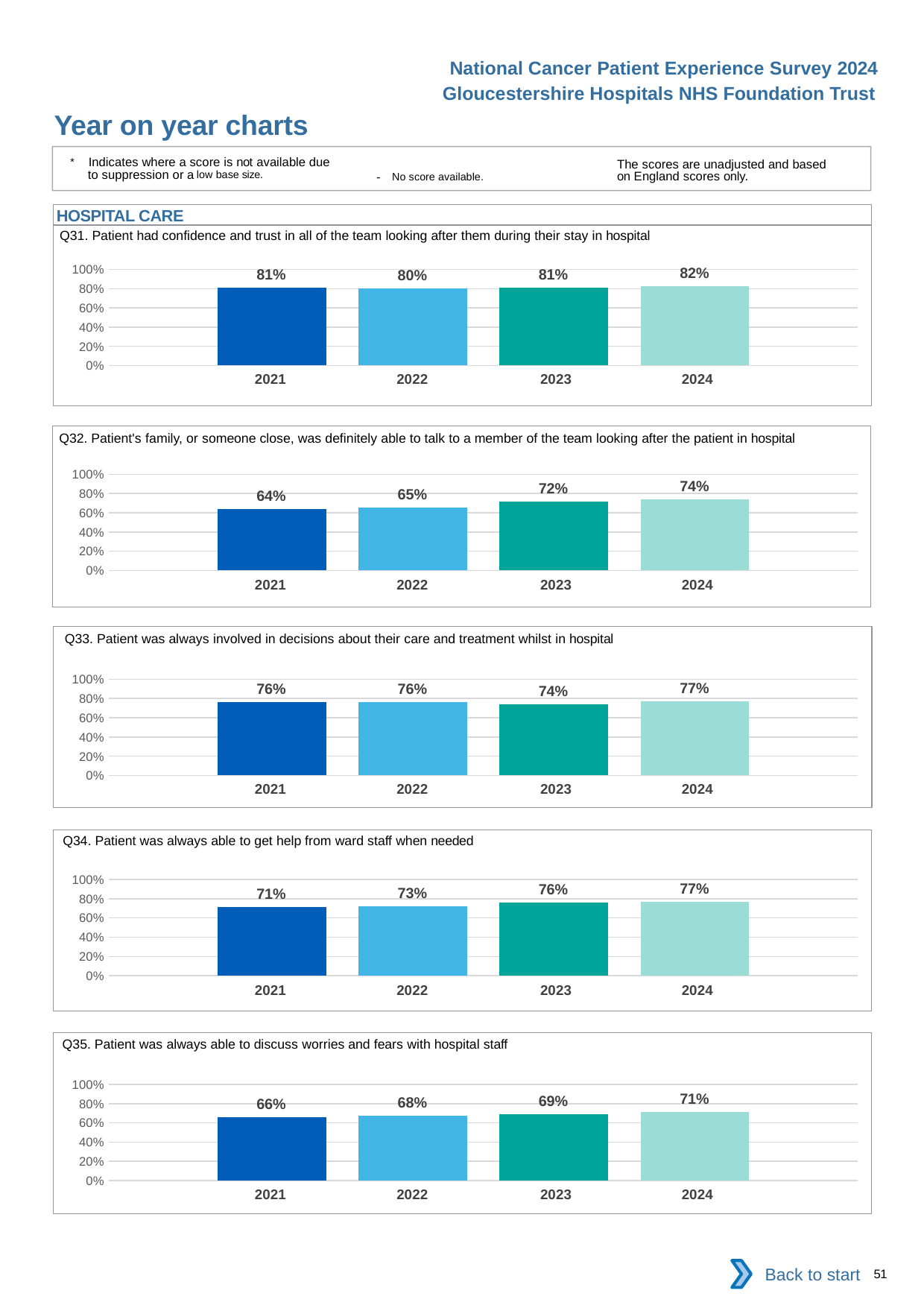
In the Q32 chart, what is the difference between the 2024 and 2021 values? 10 percentage points In the Q35 chart, do the values rise or fall from 2021 to 2024? rise In the Q35 chart, what is the difference between the 2024 and 2023 values? 2 percentage points In the Q34 chart, what is the value for 2021? 71% In the Q32 chart, which year has the lowest value? 2021 What kind of chart is the Q32 chart? bar chart In the Q33 chart, which year has the highest value? 2024 In the Q33 chart, what is the value for 2023? 74% In the Q31 chart, what is the value for 2024? 82% How many bars are in the Q31 chart? 4 In the Q34 chart, is the value for 2023 larger or smaller than the value for 2022? larger In the Q31 chart, is the value for 2022 greater or less than 60%? greater